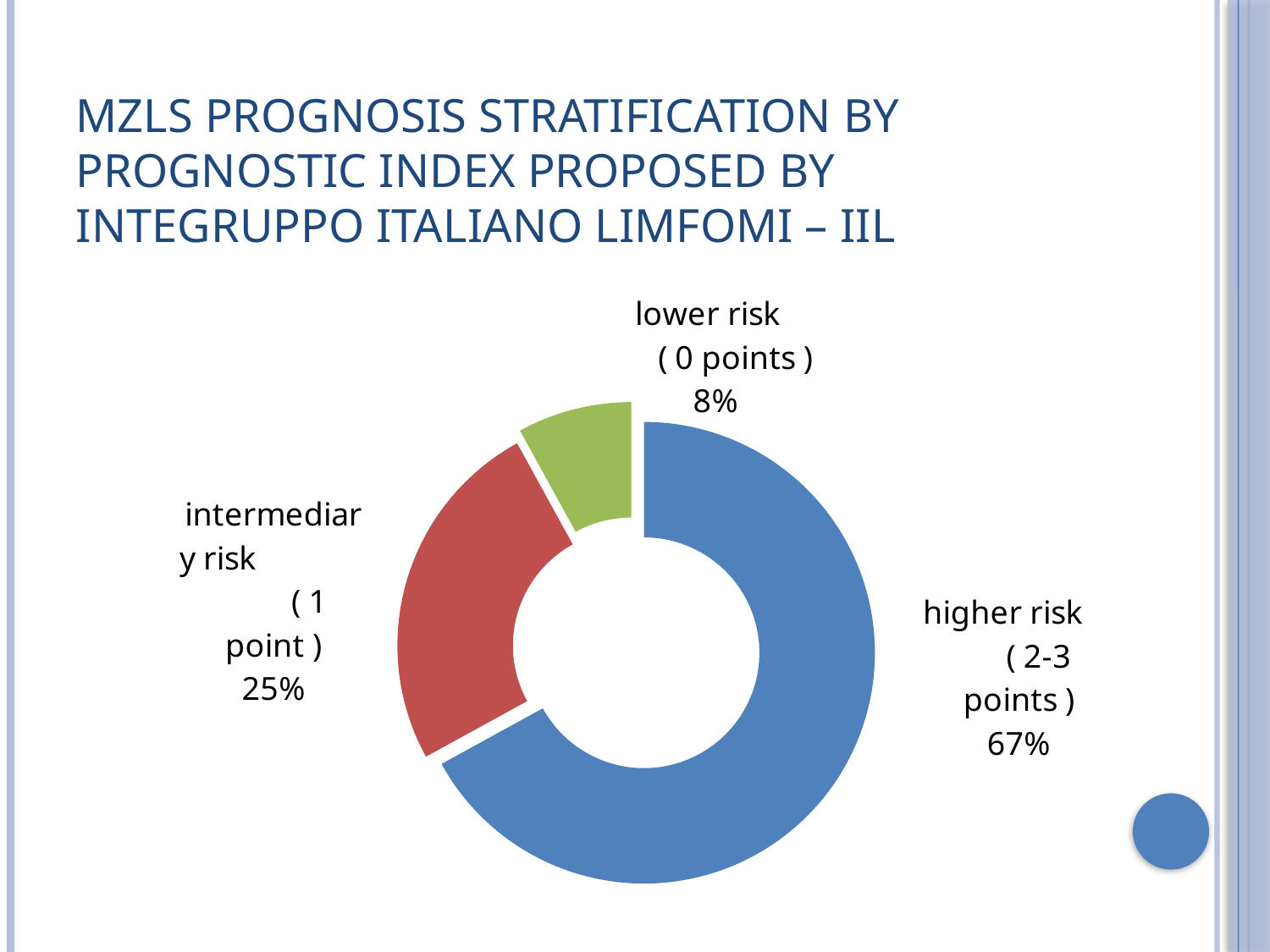
Which risk category has the smallest share of the chart? lower risk (0 points) What colour is the lower risk (0 points) slice? green What percentage of the chart is the higher risk (2-3 points) slice? 67% What is the difference in percentage points between the intermediary risk and lower risk slices? 17 Which risk category has the largest share of the chart? higher risk (2-3 points) What colour is the higher risk (2-3 points) slice? blue Which slice is larger, intermediary risk (1 point) or lower risk (0 points)? intermediary risk (1 point) What percentage of the chart is the lower risk (0 points) slice? 8% What percentage of the chart is the intermediary risk (1 point) slice? 25% How many slices does the chart have? 3 What kind of chart is shown on the slide? doughnut chart What is the difference in percentage points between the higher risk and intermediary risk slices? 42